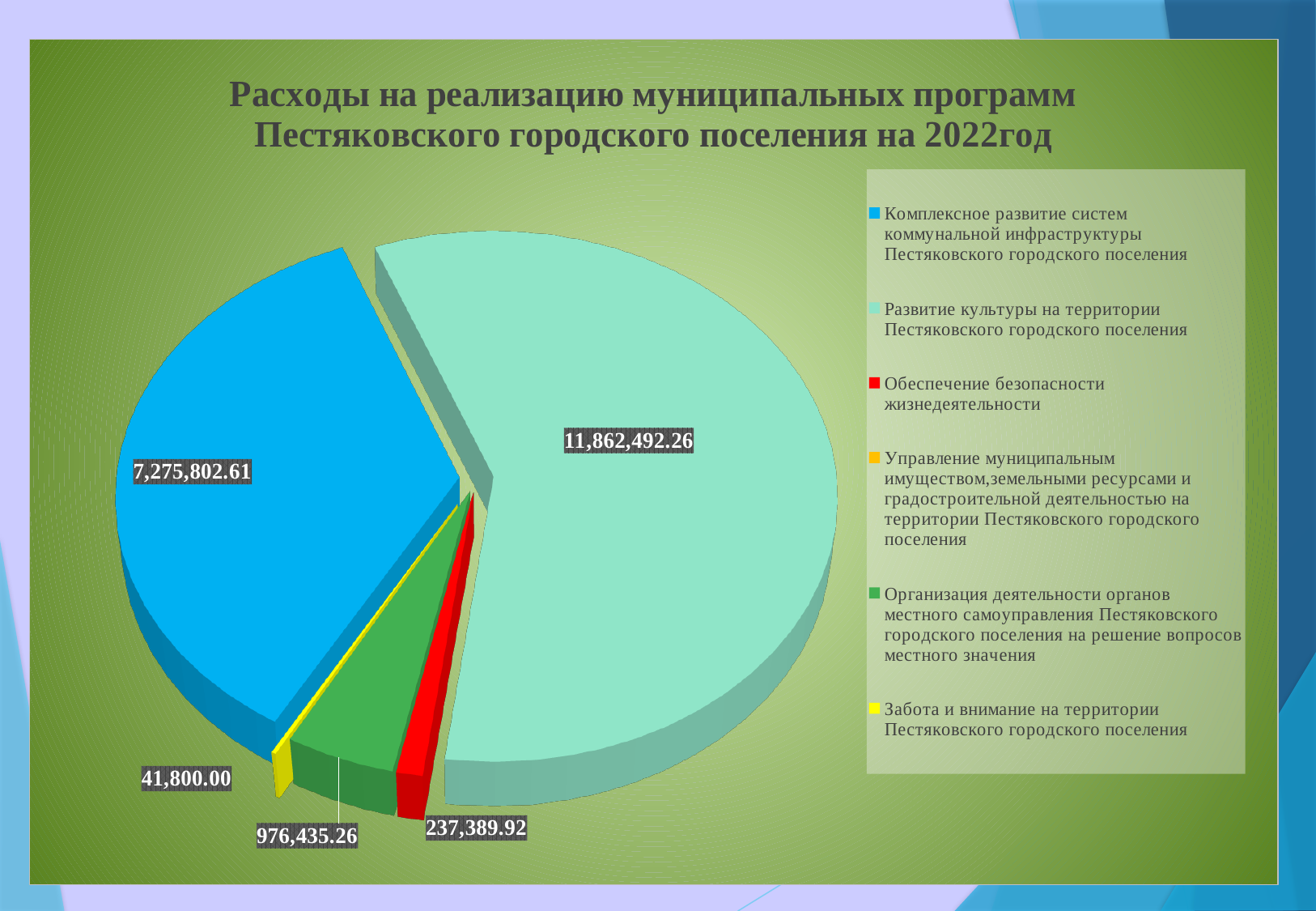
What kind of chart is shown on the slide? pie chart What is the value for "Комплексное развитие систем коммунальной инфраструктуры Пестяковского городского поселения"? 7,275,802.61 Which labeled slice has the smallest value? Забота и внимание на территории Пестяковского городского поселения What is the value for "Обеспечение безопасности жизнедеятельности"? 237,389.92 Which program has the largest expenditure in the pie chart? Развитие культуры на территории Пестяковского городского поселения What is the value for "Развитие культуры на территории Пестяковского городского поселения"? 11,862,492.26 How many entries does the legend list? 6 What is the difference between the value for "Развитие культуры" and the value for "Комплексное развитие систем коммунальной инфраструктуры"? 4,586,689.65 Which is larger: the value for "Обеспечение безопасности жизнедеятельности" or the value for "Забота и внимание"? Обеспечение безопасности жизнедеятельности What is the value for "Организация деятельности органов местного самоуправления Пестяковского городского поселения на решение вопросов местного значения"? 976,435.26 What is the value for "Забота и внимание на территории Пестяковского городского поселения"? 41,800.00 What is the difference between the value for "Организация деятельности органов местного самоуправления" and the value for "Обеспечение безопасности жизнедеятельности"? 739,045.34